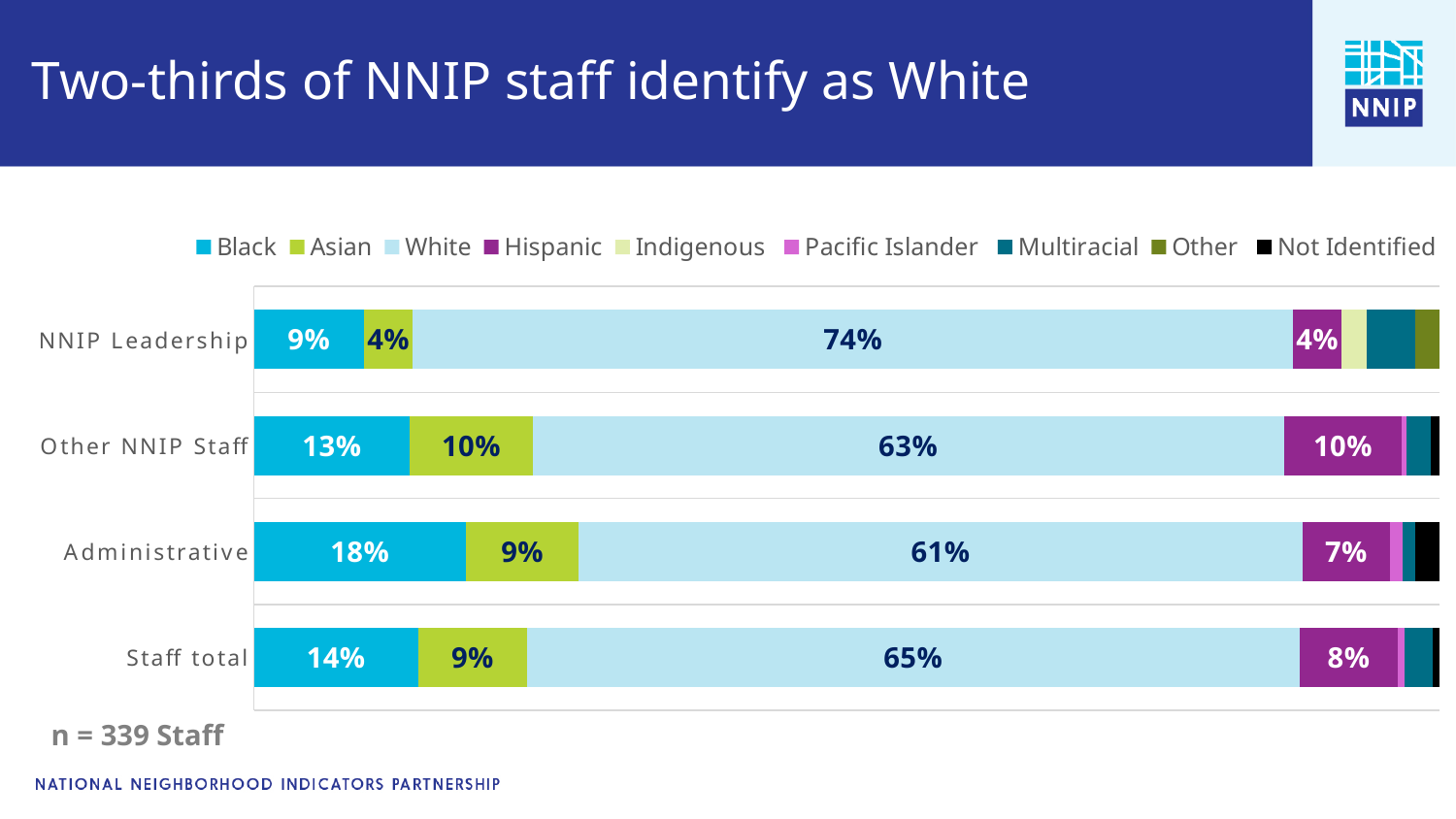
Which is larger: the Black share for Other NNIP Staff or the Black share for Administrative staff? Administrative Which staff group has the highest White percentage? NNIP Leadership How many series does the legend list? 9 What is the difference between the White percentage for NNIP Leadership and for Administrative staff? 13% What percentage of the Staff total identify as Asian? 9% How many staff groups are shown on the chart? 4 Which staff group has the lowest Black percentage? NNIP Leadership What is the Hispanic share for Other NNIP Staff? 10% What percentage of Administrative staff identify as Black? 18% What percentage of NNIP Leadership identify as White? 74% What is the sample size noted below the chart? n = 339 Staff What kind of chart is shown on the slide? Stacked bar chart